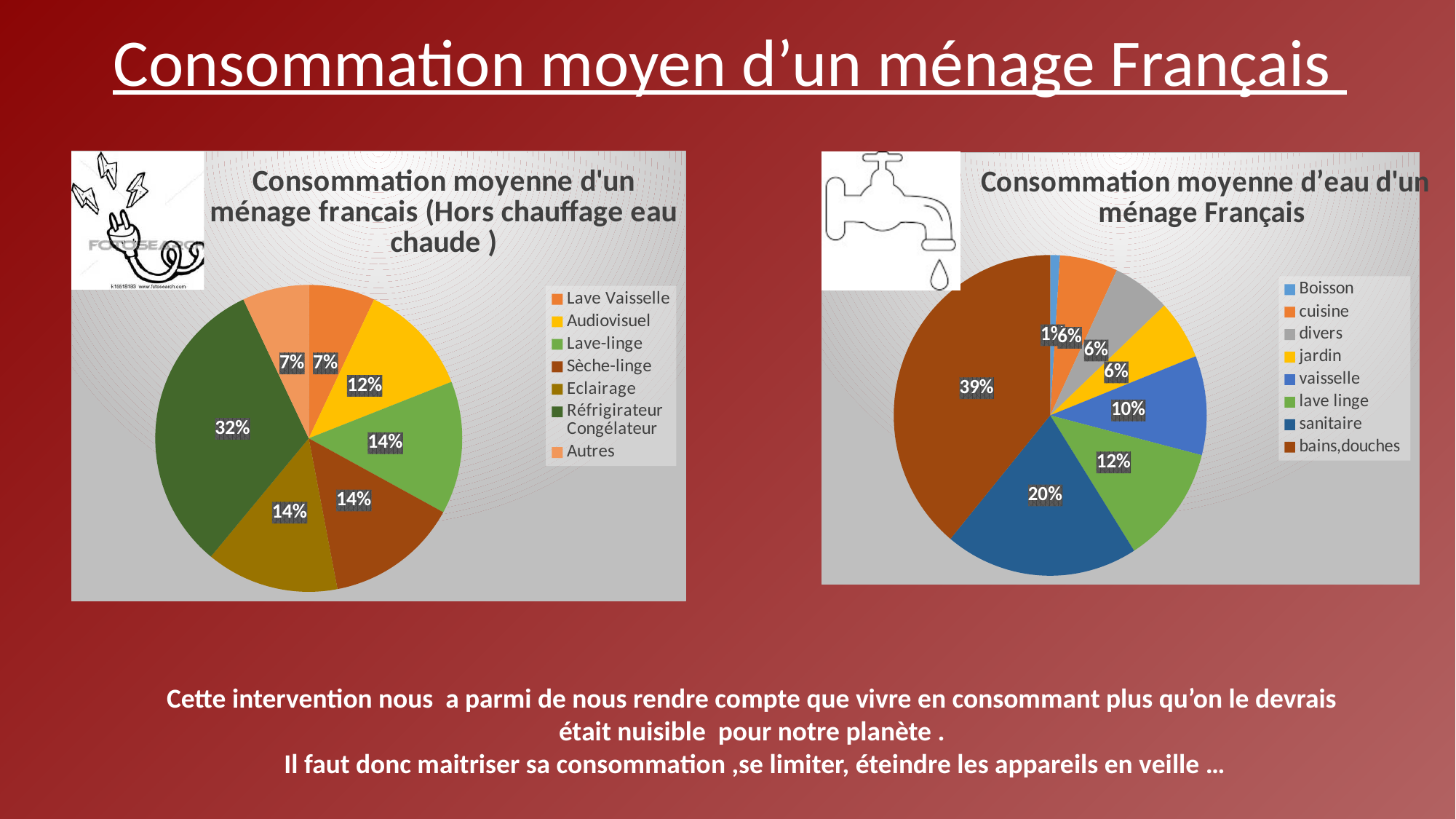
In the left chart (Consommation moyenne d'un ménage francais), how many categories does the legend list? 7 In the right chart (Consommation moyenne d'eau d'un ménage Français), what share is shown for bains,douches? 39% In the right chart (Consommation moyenne d'eau d'un ménage Français), what is the difference between the bains,douches share and the sanitaire share? 19% In the left chart (Consommation moyenne d'un ménage francais), what share does Réfrigirateur Congélateur account for? 32% In the right chart (Consommation moyenne d'eau d'un ménage Français), what percentage is shown for sanitaire? 20% What type of chart is the right chart (Consommation moyenne d'eau d'un ménage Français)? Pie chart In the right chart (Consommation moyenne d'eau d'un ménage Français), which is larger, vaisselle or lave linge? lave linge In the right chart (Consommation moyenne d'eau d'un ménage Français), how many categories are shown in the legend? 8 In the right chart (Consommation moyenne d'eau d'un ménage Français), which category has the smallest slice? Boisson In the left chart (Consommation moyenne d'un ménage francais), which category has the largest slice? Réfrigirateur Congélateur In the left chart (Consommation moyenne d'un ménage francais), what is the difference between the Réfrigirateur Congélateur share and the Lave-linge share? 18% In the left chart (Consommation moyenne d'un ménage francais), what percentage is shown for Audiovisuel? 12%